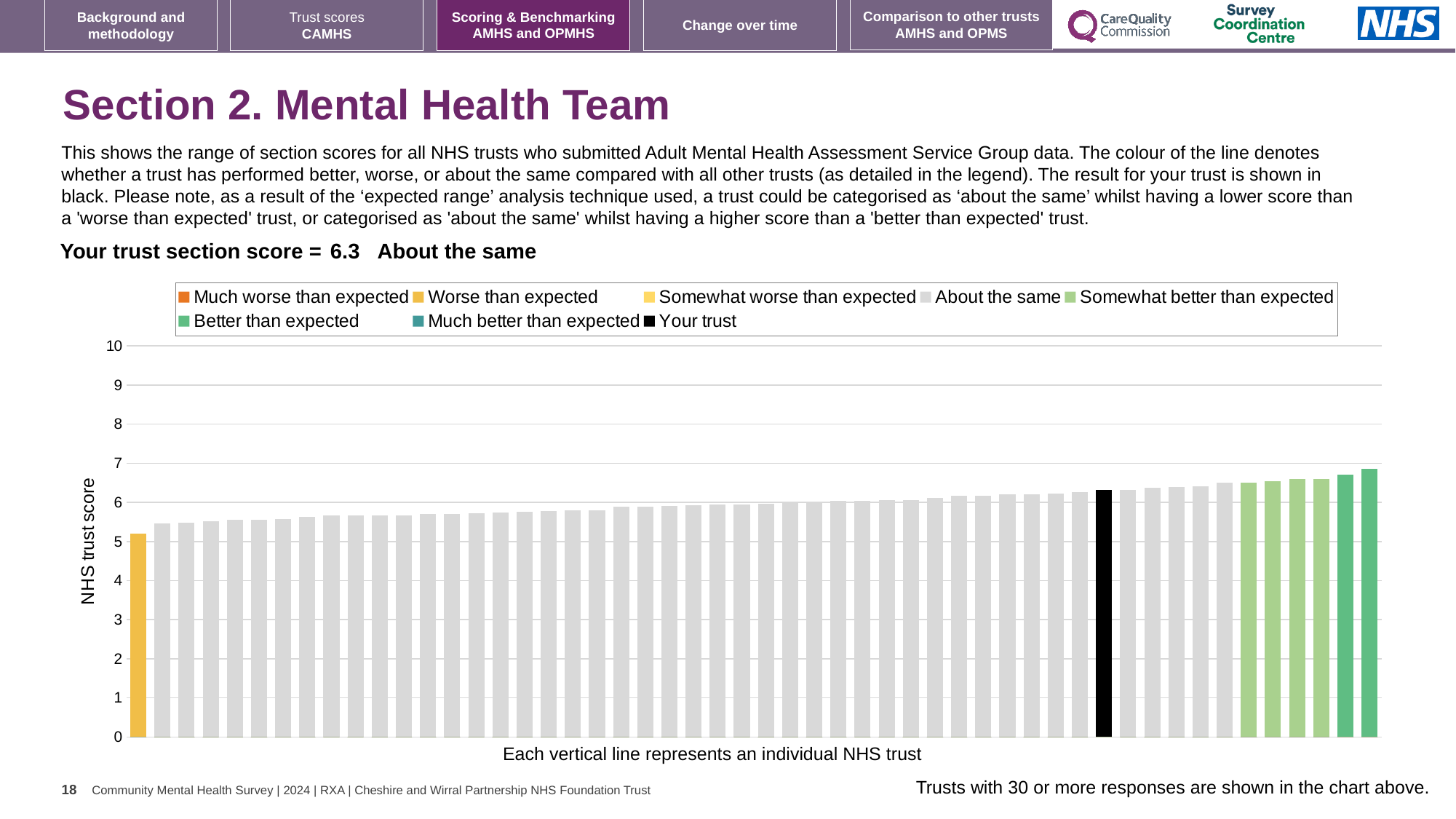
How many entries does the chart legend list? 8 How many bars are coloured as 'Somewhat better than expected' (light green)? 4 Which is larger: the value for your trust (black bar) or the value of the leftmost bar? your trust What is the section score for your trust shown on the slide? 6.3 Is the value of the lowest bar (leftmost) greater or less than 6? less Which category is your trust's section score placed in? About the same Is the value for your trust (black bar) greater or less than 6? greater What is the label on the vertical axis of the chart? NHS trust score What kind of chart is shown on the slide? bar chart Is the value for your trust (black bar) greater or less than 7? less Do the bar values rise or fall from left to right along the x axis? rise